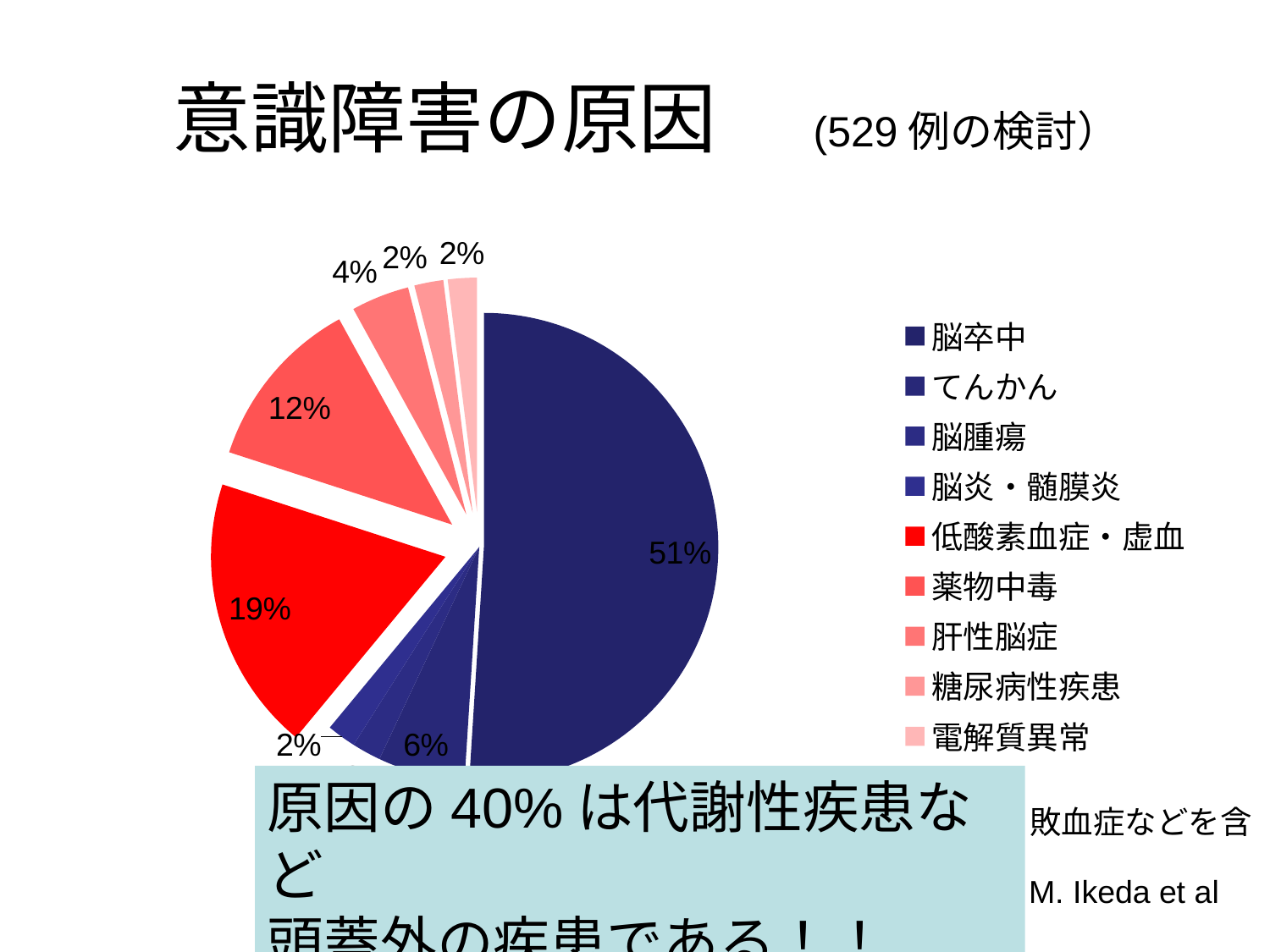
What type of chart is shown on the slide? pie chart What percentage is labelled for 肝性脳症? 4% Which category has the largest slice of the pie chart? 脳卒中 What percentage does 低酸素血症・虚血 account for in the pie chart? 19% What percentage is shown for てんかん? 6% What is the combined share of 脳卒中 and 低酸素血症・虚血? 70% How many categories does the legend of the pie chart list? 9 What is the share shown for 薬物中毒? 12% What is the title of the chart on the slide? 意識障害の原因 How many percentage points larger is the 脳卒中 slice than the 低酸素血症・虚血 slice? 32 What percentage of the pie chart is 脳卒中? 51% Which is larger, the slice for 薬物中毒 or the slice for 肝性脳症? 薬物中毒